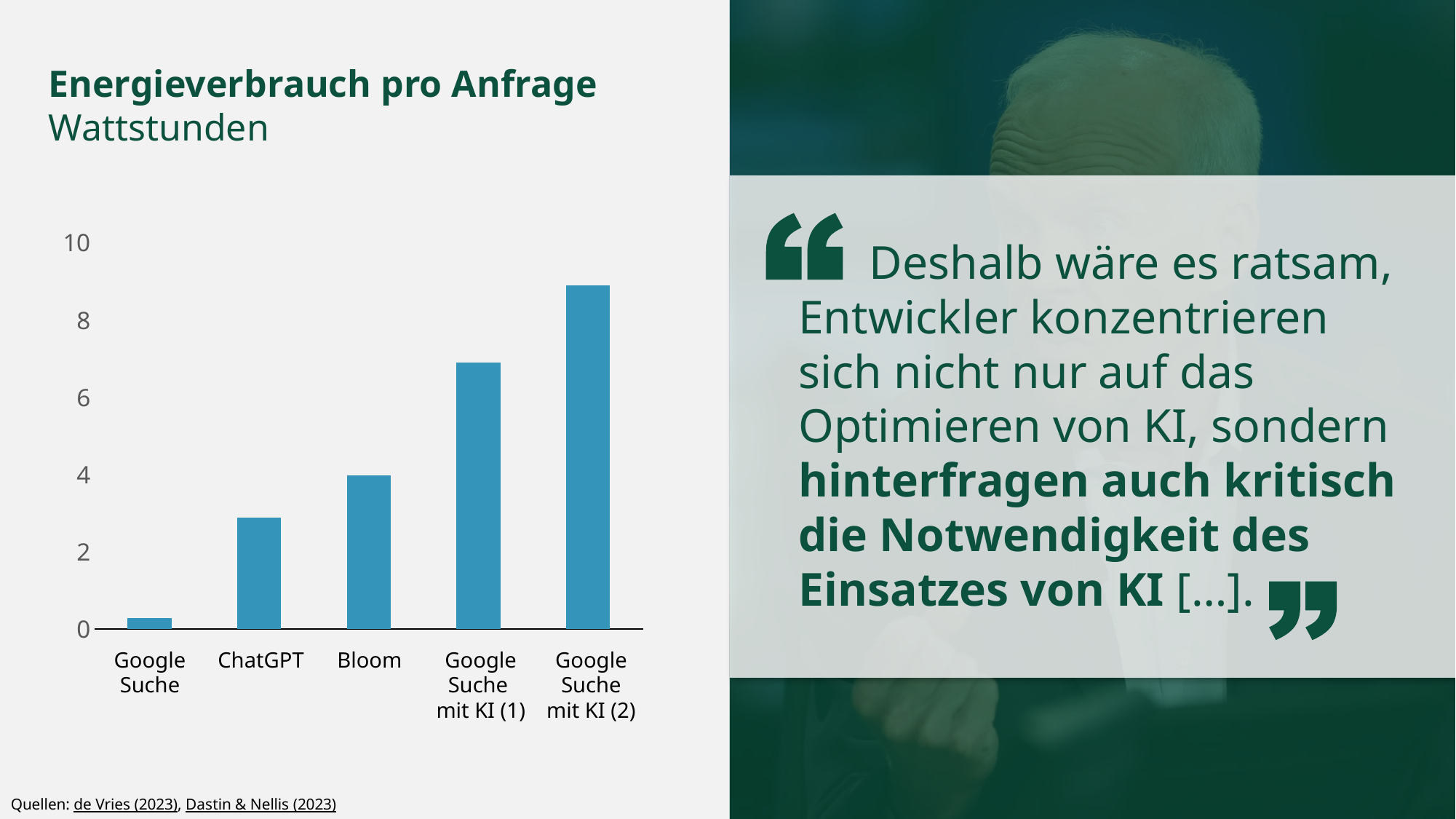
How many categories are shown on the x axis of the chart? 5 Do the values rise or fall from left to right along the x axis? rise Is the value for Google Suche mit KI (1) greater or less than 6? greater Which category has the lowest energy consumption per request? Google Suche In what unit are the values on the chart measured, according to the subtitle? Wattstunden Is the value for Google Suche greater or less than 2? less Which category has the highest energy consumption per request? Google Suche mit KI (2) Which is larger, the value for Google Suche mit KI (1) or the value for Google Suche mit KI (2)? Google Suche mit KI (2) Which is larger, the value for ChatGPT or the value for Bloom? Bloom What kind of chart is shown on the slide? bar chart Is the value for Google Suche mit KI (2) greater or less than 8? greater